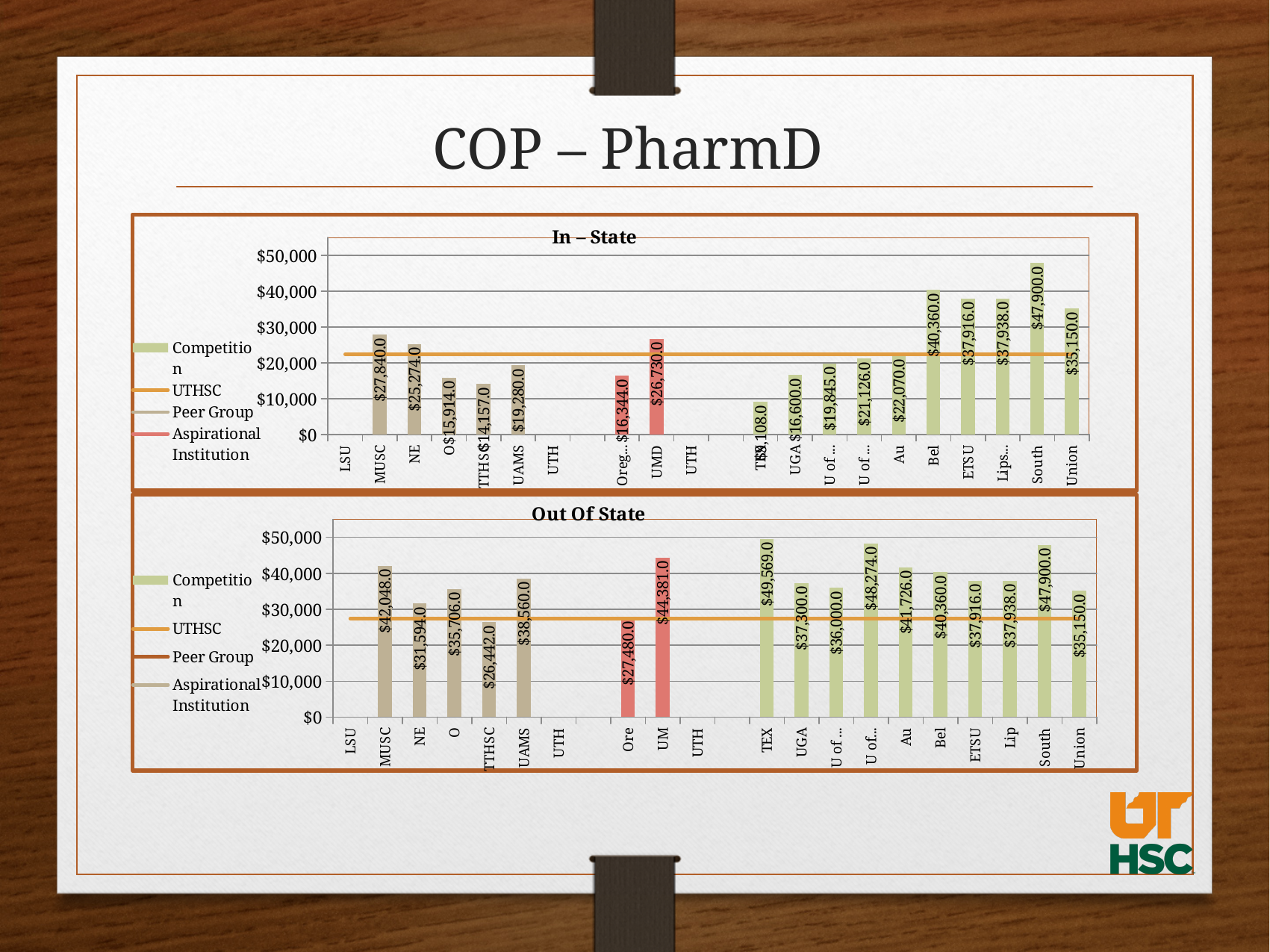
In the In – State chart, is the UTHSC line greater or less than $20,000? greater In the In – State chart, what is the difference between the values for Bel and Union? $5,210.0 In the Out Of State chart, what is the value for UM? $44,381.0 In the Out Of State chart, which labeled institution has the lowest value? TTHSC In the Out Of State chart, what is the difference between the values for TEX and South? $1,669.0 How many series does the legend of the Out Of State chart list? 4 In the In – State chart, which is larger, the value for MUSC or the value for NE? MUSC In the Out Of State chart, what is the value for MUSC? $42,048.0 In the In – State chart, what is the value for South? $47,900.0 In the Out Of State chart, which institution has the highest value? TEX What kind of chart is the In – State chart? bar chart In the In – State chart, which institution has the highest value? South